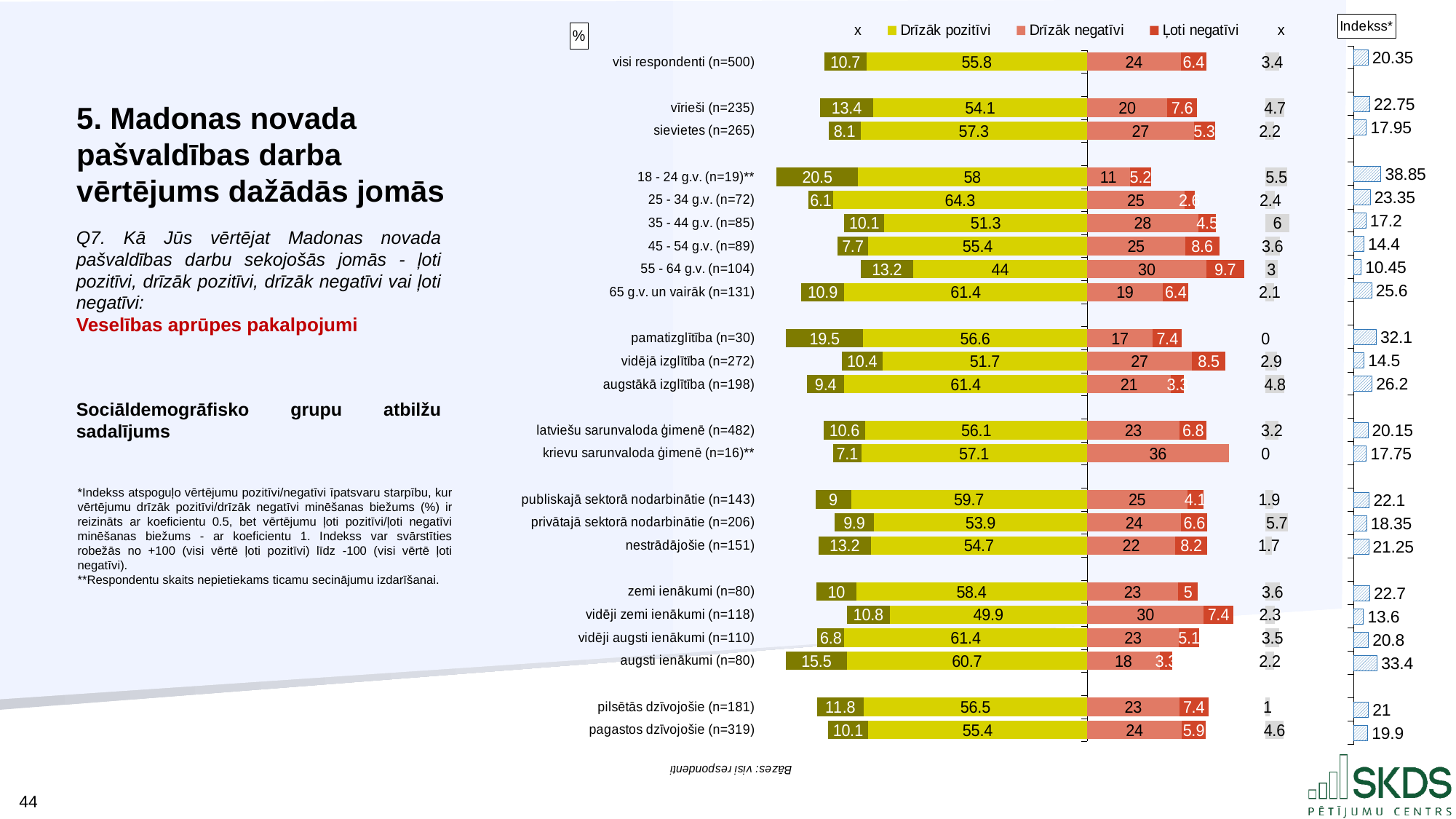
Which group has the highest "Drīzāk pozitīvi" value? 25 - 34 g.v. (n=72) What is the "Ļoti negatīvi" value for the 55 - 64 g.v. (n=104) group? 9.7 What is the difference between the Indekss* values for pilsētās dzīvojošie (n=181) and pagastos dzīvojošie (n=319)? 1.1 What kind of chart is used to show the response distribution? Stacked bar chart Which group has the lowest Indekss* value? 55 - 64 g.v. (n=104) What is the "Drīzāk negatīvi" value for krievu sarunvaloda ģimenē (n=16)**? 36 What colour represents "Drīzāk pozitīvi" in the chart? Yellow What is the "Drīzāk pozitīvi" value for visi respondenti (n=500)? 55.8 What is the difference between the "Drīzāk pozitīvi" values for sievietes (n=265) and vīrieši (n=235)? 3.2 Which group has the highest Indekss* value? 18 - 24 g.v. (n=19)** Which has the higher Indekss* value, vīrieši (n=235) or sievietes (n=265)? vīrieši (n=235) What is the Indekss* value for the 18 - 24 g.v. (n=19)** group? 38.85